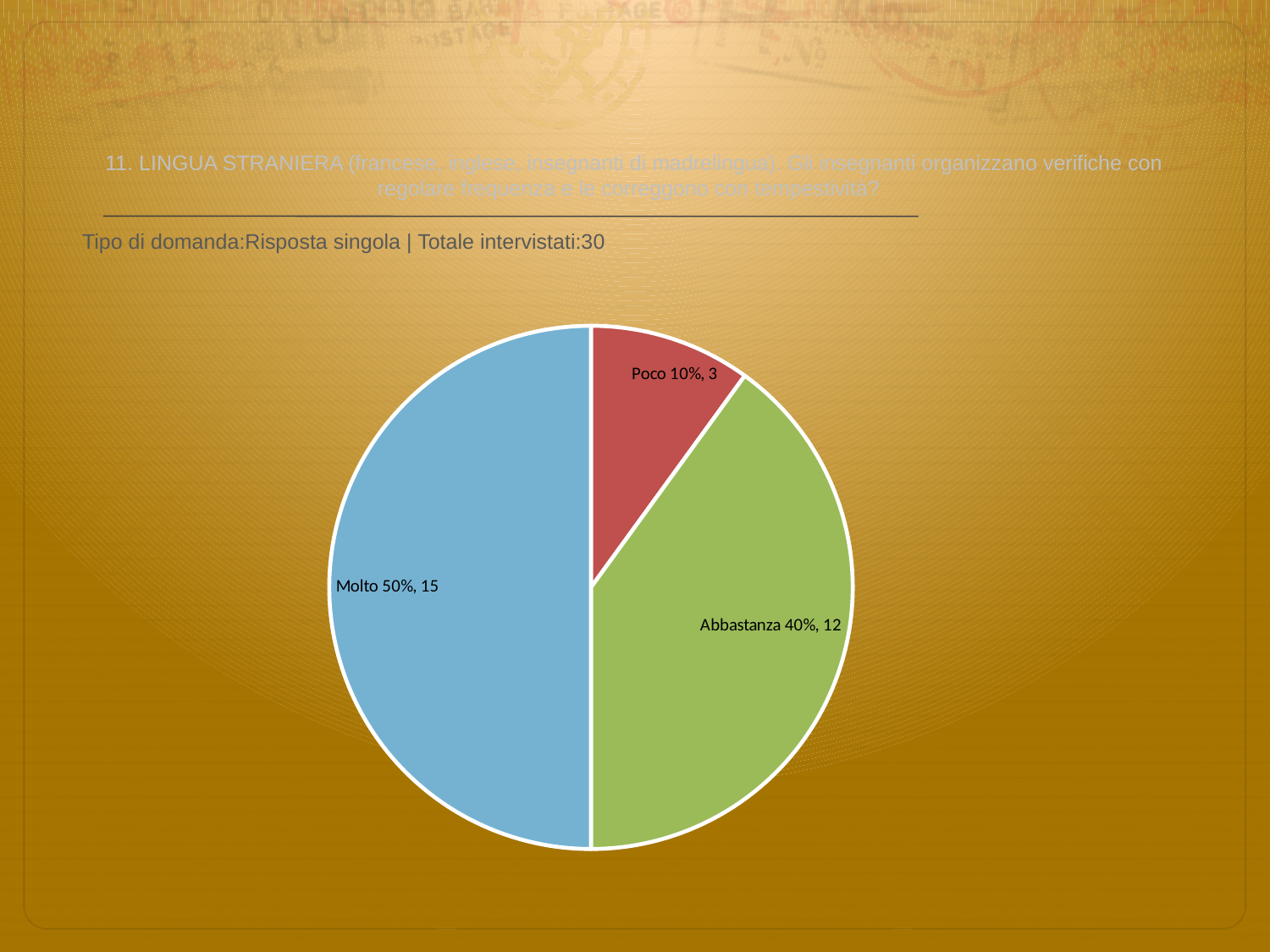
What percentage share does the Molto slice have? 50% How many respondents answered Poco? 3 Which category has the smallest slice? Poco Which category has the largest slice? Molto Which is larger, the Abbastanza slice or the Poco slice? Abbastanza What percentage share does the Poco slice have? 10% How many respondents answered Molto? 15 How many respondents answered Abbastanza? 12 What percentage share does the Abbastanza slice have? 40% What is the difference in respondent count between Molto and Abbastanza? 3 What kind of chart is shown on the slide? pie chart How many slices does the pie chart have? 3